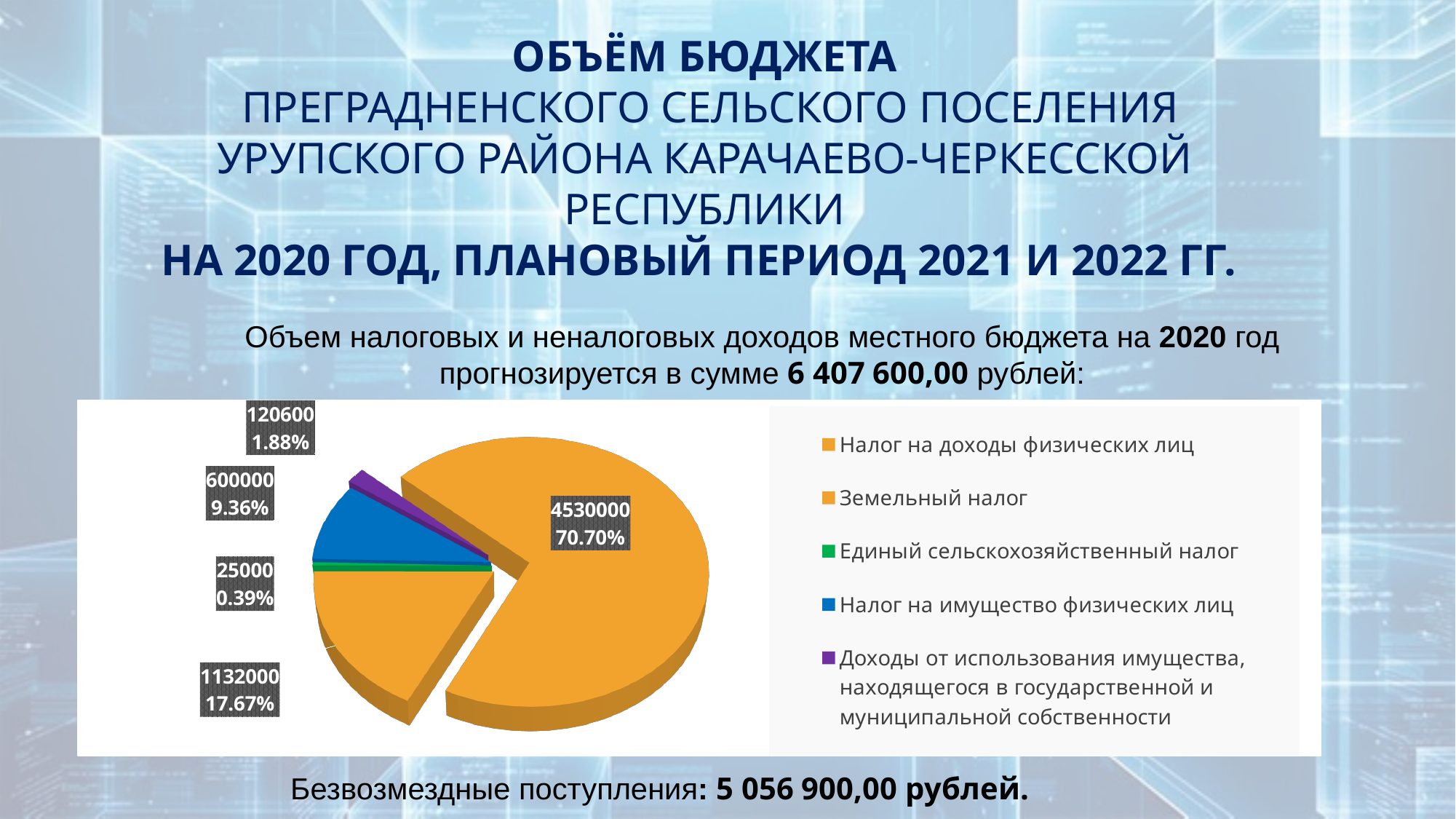
What percentage is shown for Земельный налог? 17.67% What is the difference between the values for Налог на доходы физических лиц and Земельный налог? 3398000 Which category has the smallest slice in the pie chart? Единый сельскохозяйственный налог What value is shown for Налог на доходы физических лиц in the pie chart? 4530000 What colour is the slice for Налог на имущество физических лиц? Blue What share of the pie does Налог на доходы физических лиц represent? 70.70% What kind of chart is shown on the slide? Pie chart Which category has the largest slice in the pie chart? Налог на доходы физических лиц Which is larger: the value for Налог на имущество физических лиц or the value for Доходы от использования имущества, находящегося в государственной и муниципальной собственности? Налог на имущество физических лиц What percentage is shown for Единый сельскохозяйственный налог? 0.39% How many categories does the legend of the pie chart list? 5 What value is shown for Налог на имущество физических лиц? 600000